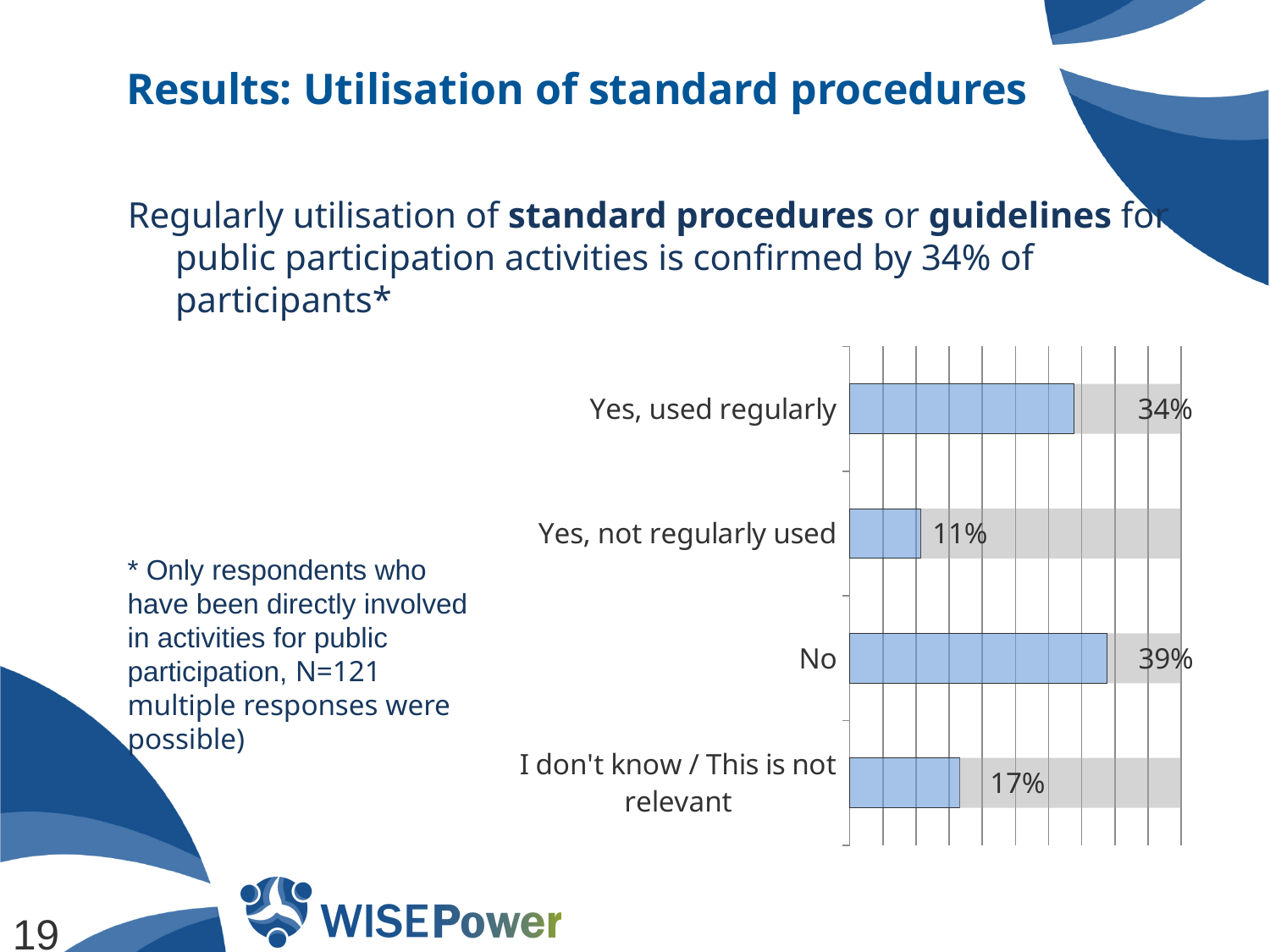
What is the difference between the values for "I don't know / This is not relevant" and "Yes, not regularly used"? 6% Which is larger, the value for "Yes, used regularly" or the value for "I don't know / This is not relevant"? Yes, used regularly What is the difference between the values for "No" and "Yes, used regularly"? 5% What percentage of respondents answered "Yes, used regularly"? 34% Which category has the lowest value? Yes, not regularly used What kind of chart is shown on the slide? Bar chart What is the combined value of the two "Yes" categories? 45% Which category has the highest value? No What is the value for "No"? 39% What is the value for "I don't know / This is not relevant"? 17% How many categories are shown in the chart? 4 What is the value for "Yes, not regularly used"? 11%